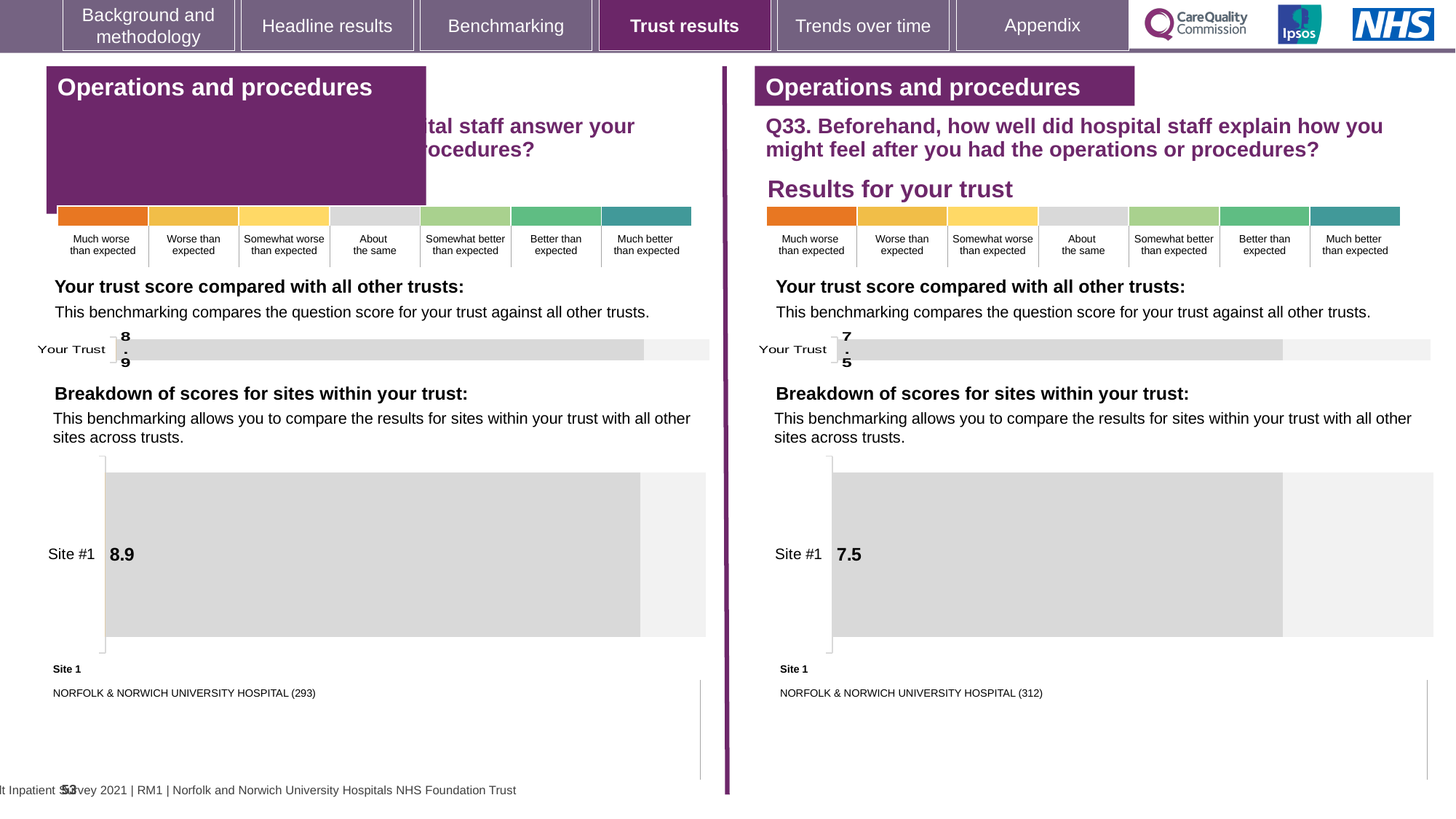
How many sites are shown in the left-hand site breakdown chart? 1 On the right half of the slide (Q33), what is the score shown for Your Trust? 7.5 What is the name of the site labelled Site 1 in the left-hand chart? NORFOLK & NORWICH UNIVERSITY HOSPITAL (293) What is the name of the site labelled Site 1 in the right-hand chart (Q33)? NORFOLK & NORWICH UNIVERSITY HOSPITAL (312) How many sites are shown in the right-hand site breakdown chart (Q33)? 1 In the left-hand site breakdown chart, what is the score for Site #1? 8.9 What type of chart is used to show the Site #1 score on the right half of the slide? Bar chart On the left half of the slide, what is the score shown for Your Trust? 8.9 Which is larger: the Your Trust score on the left half of the slide or the Your Trust score on the right half (Q33)? Left half (8.9) In the right-hand site breakdown chart (Q33), what is the score for Site #1? 7.5 What is the difference between the Site #1 score in the left-hand chart and the Site #1 score in the right-hand chart? 1.4